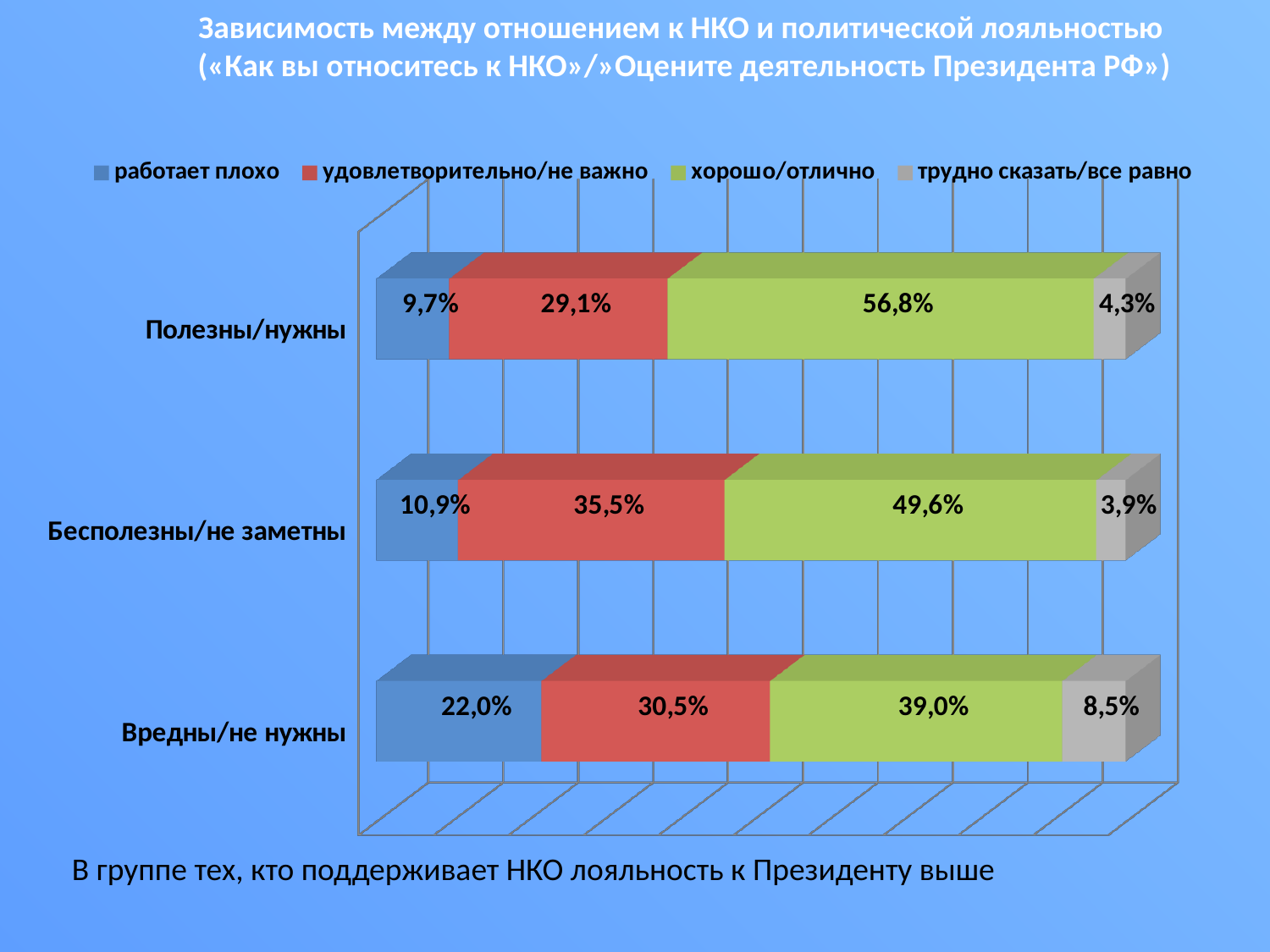
What is the total of the stacked bar for «Вредны/не нужны»? 100,0% What is the value for «хорошо/отлично» in the «Полезны/нужны» category? 56,8% What is the value for «работает плохо» in the «Вредны/не нужны» category? 22,0% What is the value for «удовлетворительно/не важно» in the «Бесполезны/не заметны» category? 35,5% What is the difference between the «хорошо/отлично» values for «Полезны/нужны» and «Вредны/не нужны»? 17,8 percentage points How many categories are shown on the chart? 3 What is the value for «трудно сказать/все равно» in the «Бесполезны/не заметны» category? 3,9% Which category has the lowest value for «работает плохо»? Полезны/нужны Which is larger: the «работает плохо» value for «Вредны/не нужны» or for «Бесполезны/не заметны»? Вредны/не нужны Which category has the highest value for «хорошо/отлично»? Полезны/нужны How many series does the legend list? 4 What kind of chart is shown on the slide? Stacked bar chart